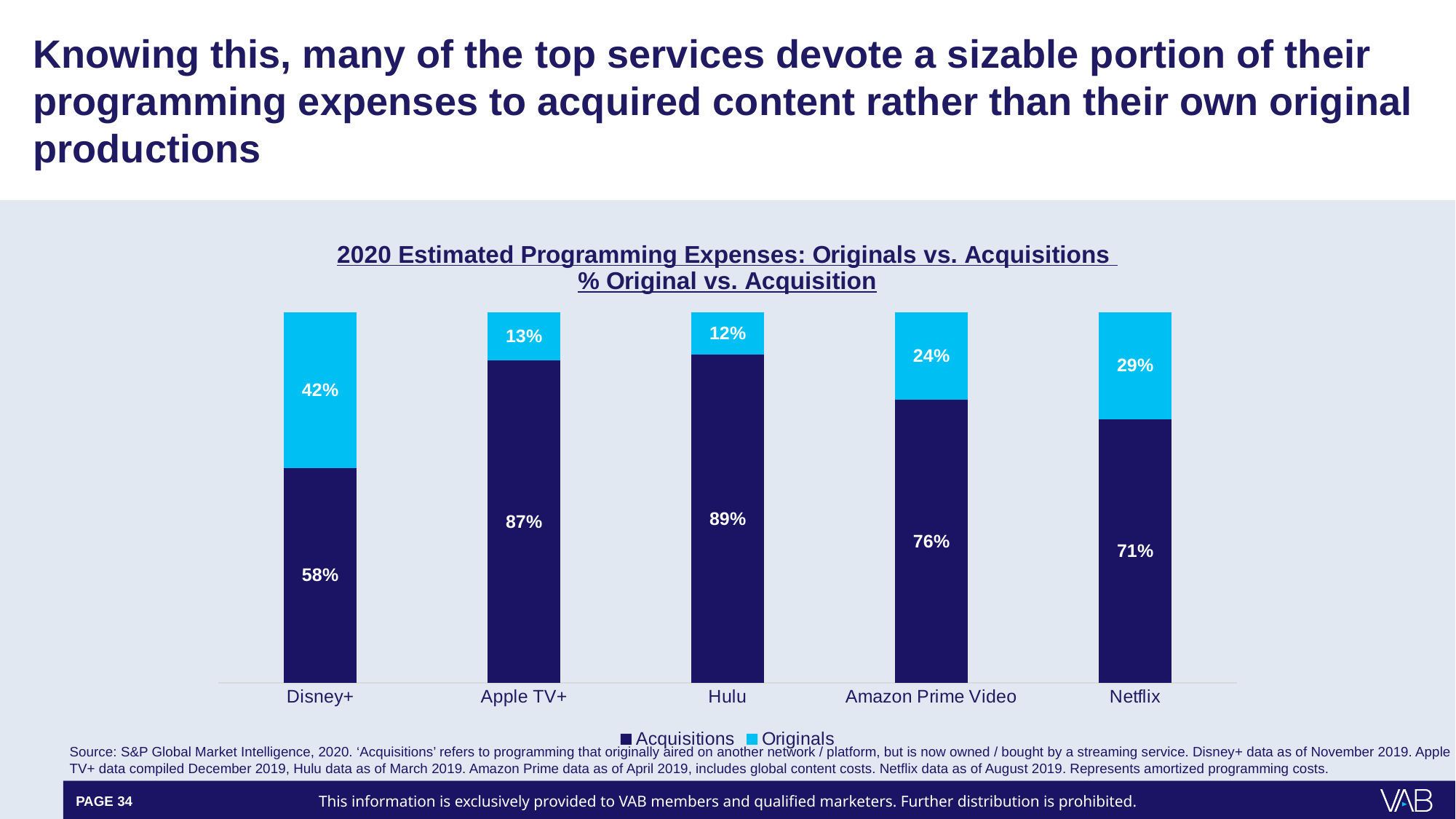
Which service has the lowest Originals share? Hulu What is the Acquisitions share for Hulu? 89% What is the Acquisitions share for Disney+? 58% How many services are shown on the chart? 5 Which is larger: the Originals share for Amazon Prime Video or for Apple TV+? Amazon Prime Video What is the difference between the Acquisitions share of Apple TV+ and that of Netflix? 16% How many series does the legend list? 2 What is the Originals share for Netflix? 29% What is the Originals share for Amazon Prime Video? 24% What kind of chart is shown on the slide? Stacked bar chart Which service has the highest Originals share? Disney+ Which service has the lowest Acquisitions share? Disney+